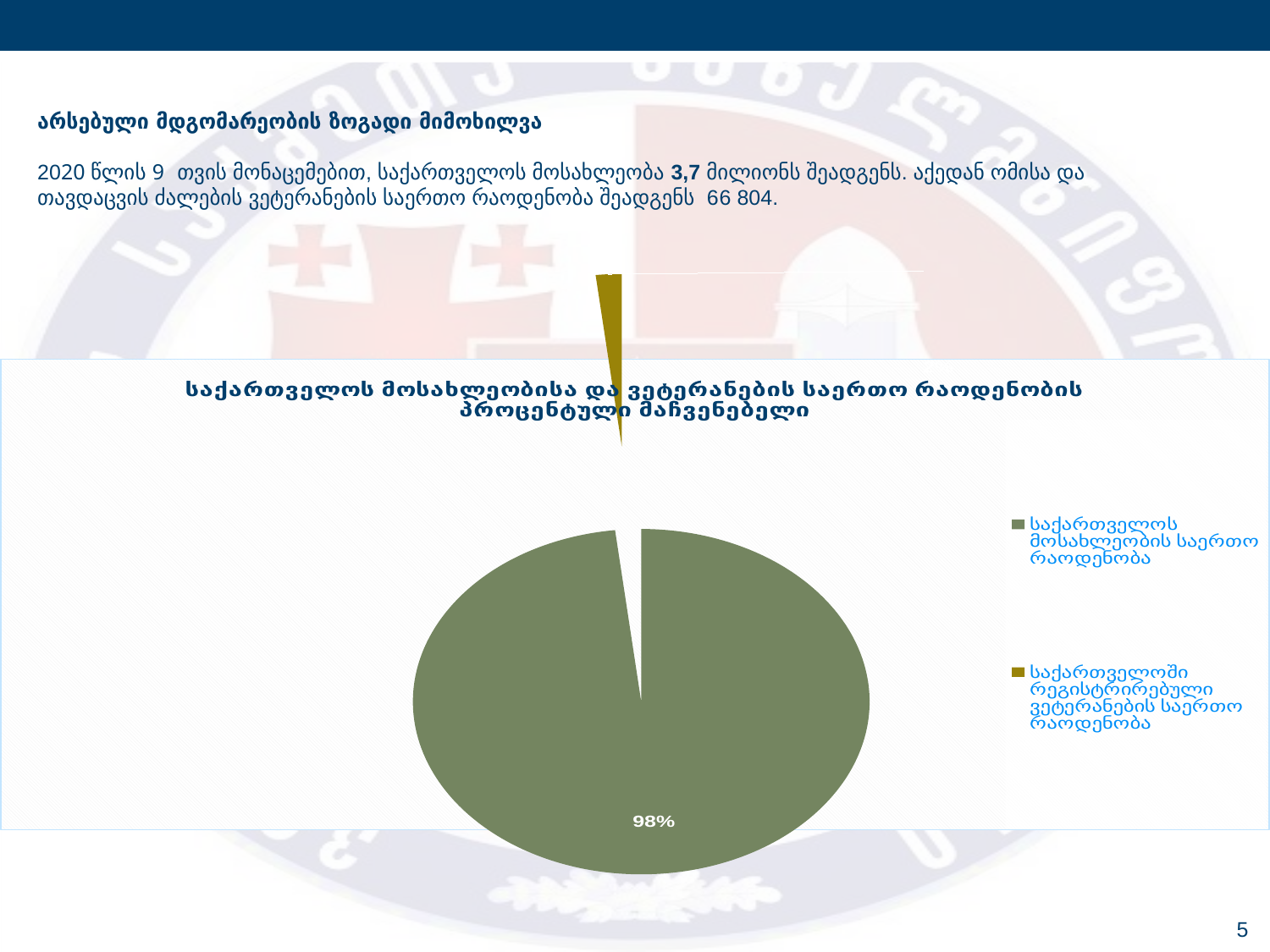
What share of the pie does საქართველოს მოსახლეობის საერთო რაოდენობა take? 98% What kind of chart is shown on the slide? pie chart How many entries does the legend of the pie chart list? 2 How many slices does the pie chart have? 2 Which is larger in the pie chart: the slice for საქართველოს მოსახლეობის საერთო რაოდენობა or the slice for საქართველოში რეგისტრირებული ვეტერანების საერთო რაოდენობა? საქართველოს მოსახლეობის საერთო რაოდენობა What colour is the slice representing საქართველოს მოსახლეობის საერთო რაოდენობა? green Which category has the smallest slice in the pie chart? საქართველოში რეგისტრირებული ვეტერანების საერთო რაოდენობა What percentage is printed on the large green slice of the pie chart? 98% Which category has the largest slice in the pie chart? საქართველოს მოსახლეობის საერთო რაოდენობა What is the title of the pie chart? საქართველოს მოსახლეობისა და ვეტერანების საერთო რაოდენობის პროცენტული მაჩვენებელი